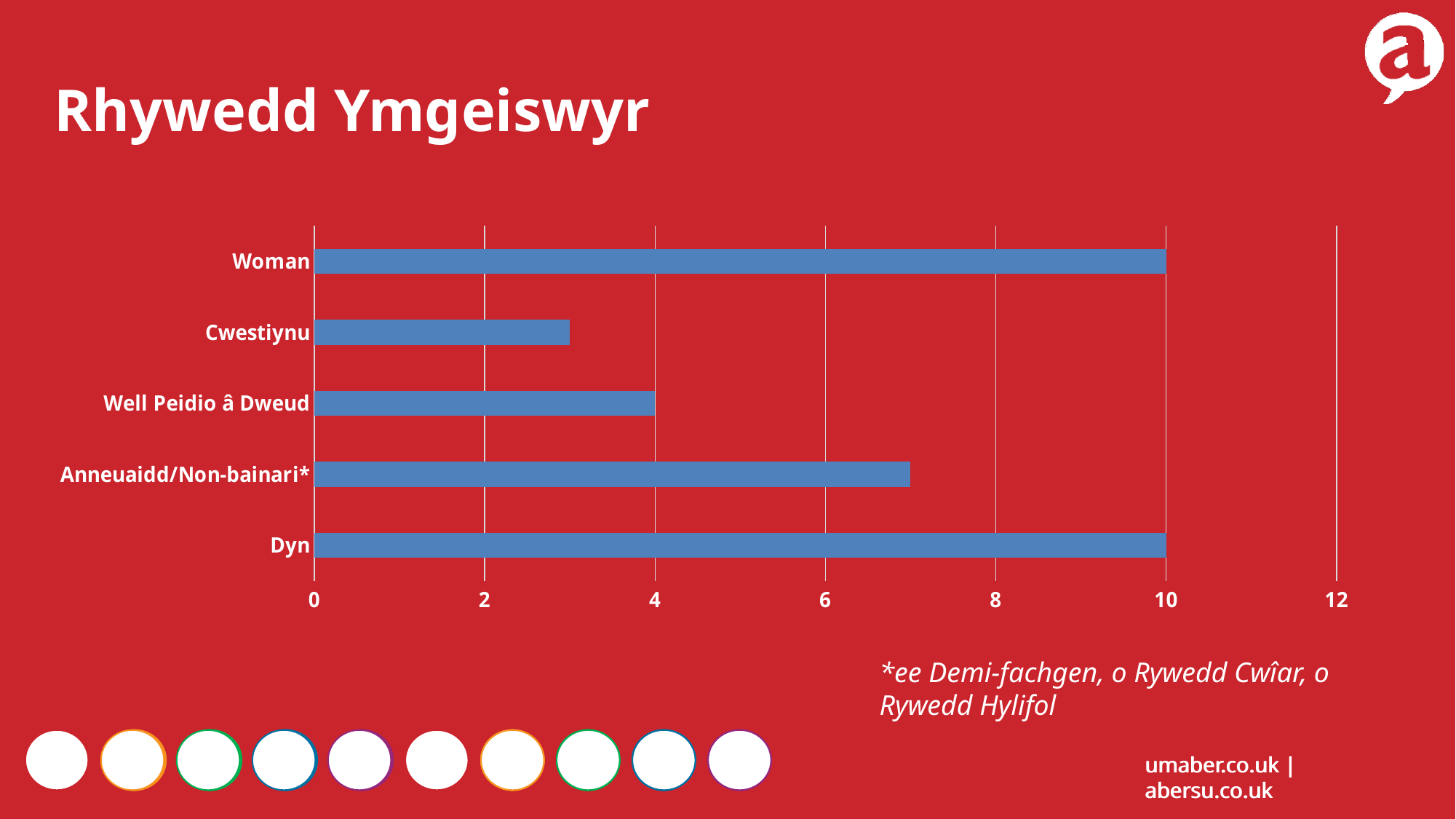
Which category has the lowest value? Cwestiynu What type of chart is shown on the slide? Bar chart Is the value for Cwestiynu greater or less than 4? less What is the value for Well Peidio â Dweud? 4 How many categories are shown in the chart? 5 What is the difference between the value for Woman and the value for Well Peidio â Dweud? 6 What is the value for Woman? 10 What is the value for Dyn? 10 Is the value for Anneuaidd/Non-bainari* greater or less than 6? greater Is the value for Anneuaidd/Non-bainari* greater or less than 8? less Which is larger, the value for Anneuaidd/Non-bainari* or the value for Well Peidio â Dweud? Anneuaidd/Non-bainari* What is the title of the chart? Rhywedd Ymgeiswyr